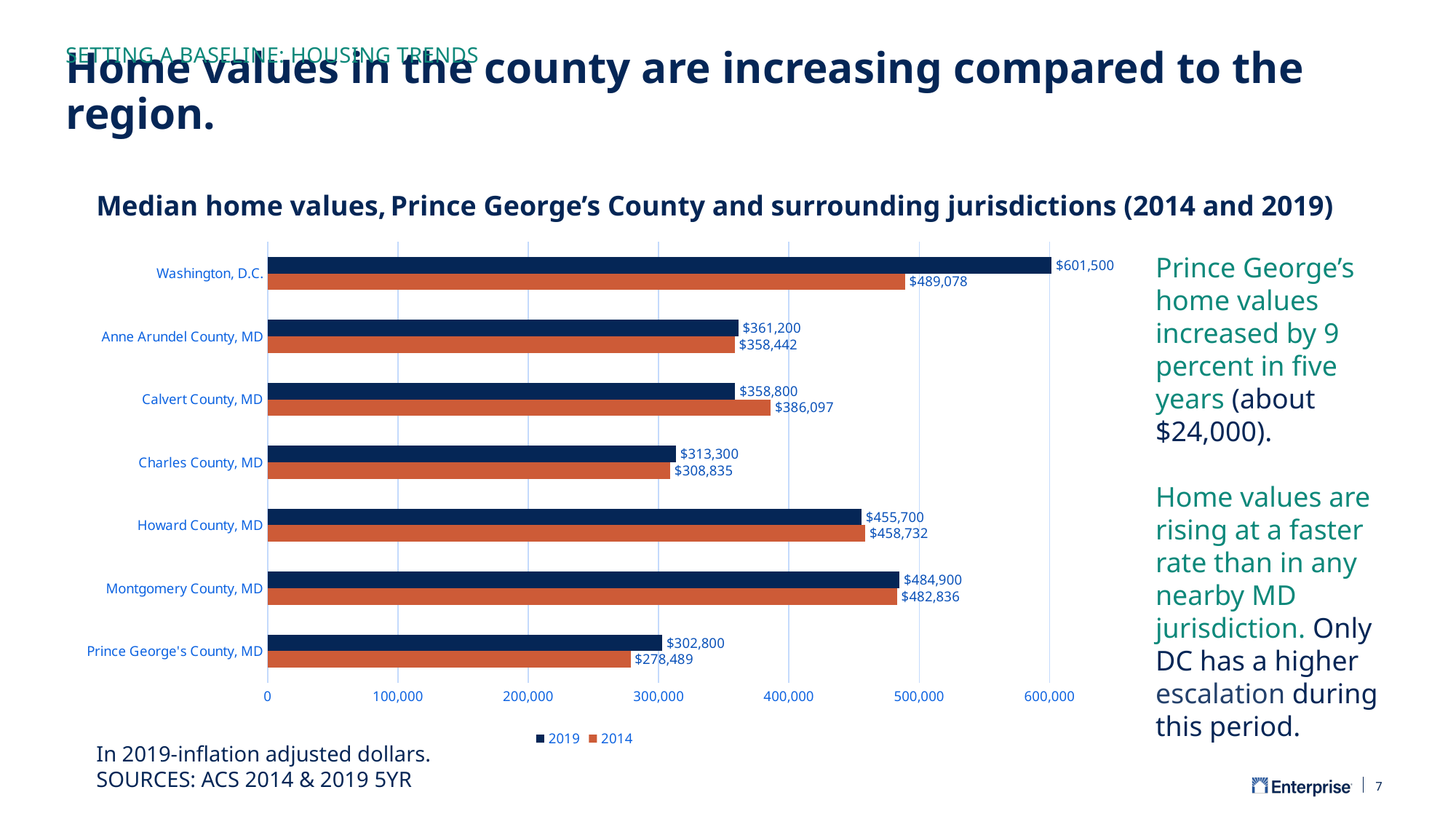
Which jurisdiction has the highest 2019 median home value? Washington, D.C. How many jurisdictions are shown in the chart? 7 Is the 2019 median home value for Montgomery County, MD greater or less than 400,000? greater For Calvert County, MD, which year has the larger median home value, 2014 or 2019? 2014 What is the 2019 median home value for Washington, D.C.? $601,500 What is the difference between the 2019 and 2014 median home values for Washington, D.C.? $112,422 What type of chart is shown on the slide? Bar chart How many series does the legend list? 2 Which jurisdiction has the lowest 2019 median home value? Prince George's County, MD What is the 2014 median home value for Prince George's County, MD? $278,489 By how much did the median home value in Prince George's County, MD increase from 2014 to 2019? $24,311 What is the 2014 median home value for Calvert County, MD? $386,097